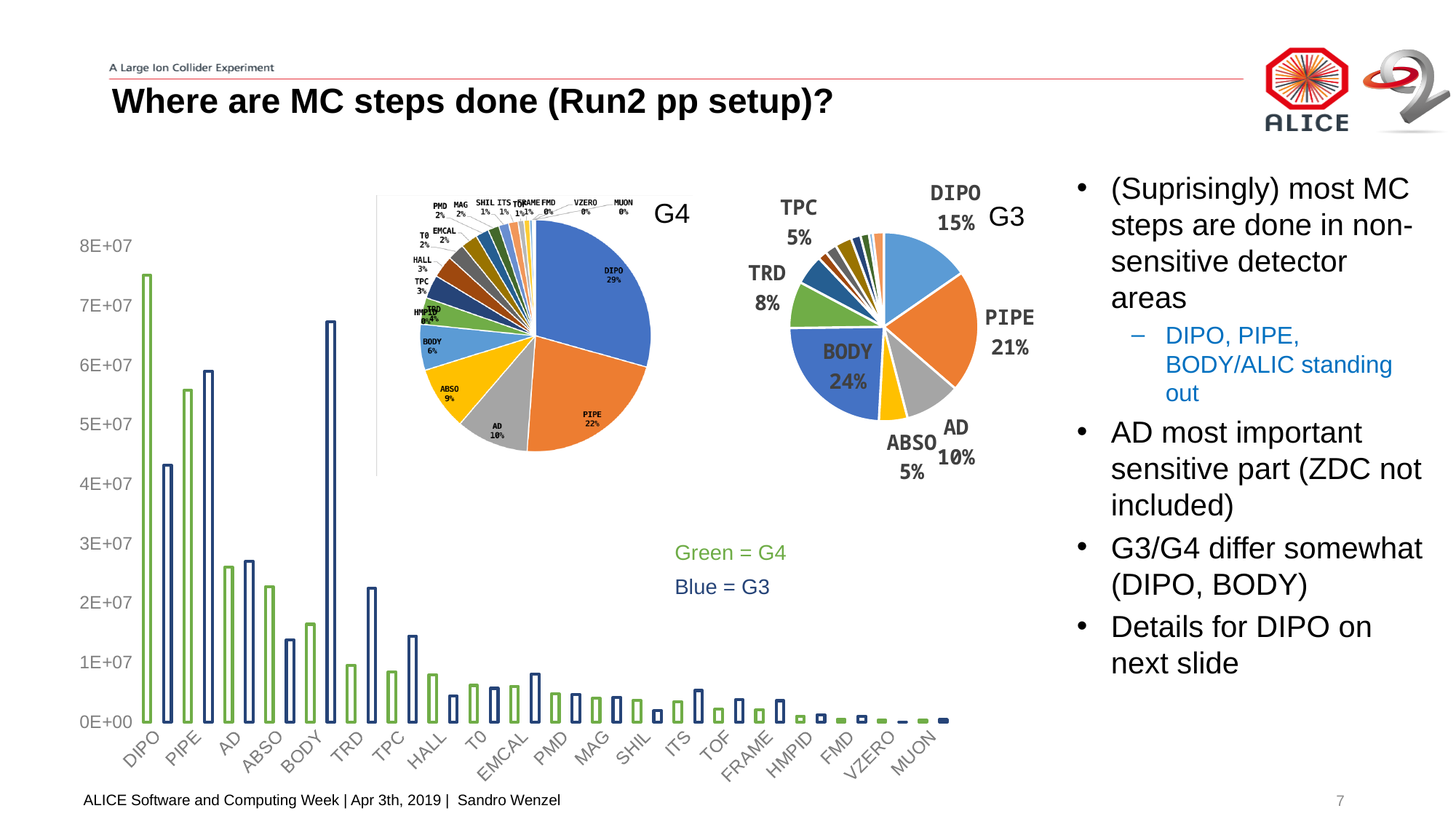
In the G3 pie chart, which is larger, DIPO or PIPE? PIPE In the G4 pie chart, what share does DIPO have? 29% In the G3 pie chart, what share does BODY have? 24% What kind of chart is the chart on the bottom left of the slide? Bar chart In the G4 pie chart, what share does PIPE have? 22% In the G3 pie chart, which slice is the largest? BODY In the bar chart on the bottom left, which category has the tallest green (G4) bar? DIPO In the G3 pie chart, what is the difference between the PIPE share and the DIPO share? 6 percentage points In the G4 pie chart, which slice is the largest? DIPO In the bar chart on the bottom left, how many categories are shown on the x axis? 20 In the bar chart on the bottom left, is the green (G4) value for DIPO greater or less than 7E+07? greater In the bar chart on the bottom left, is the blue (G3) value for BODY greater or less than 6E+07? greater